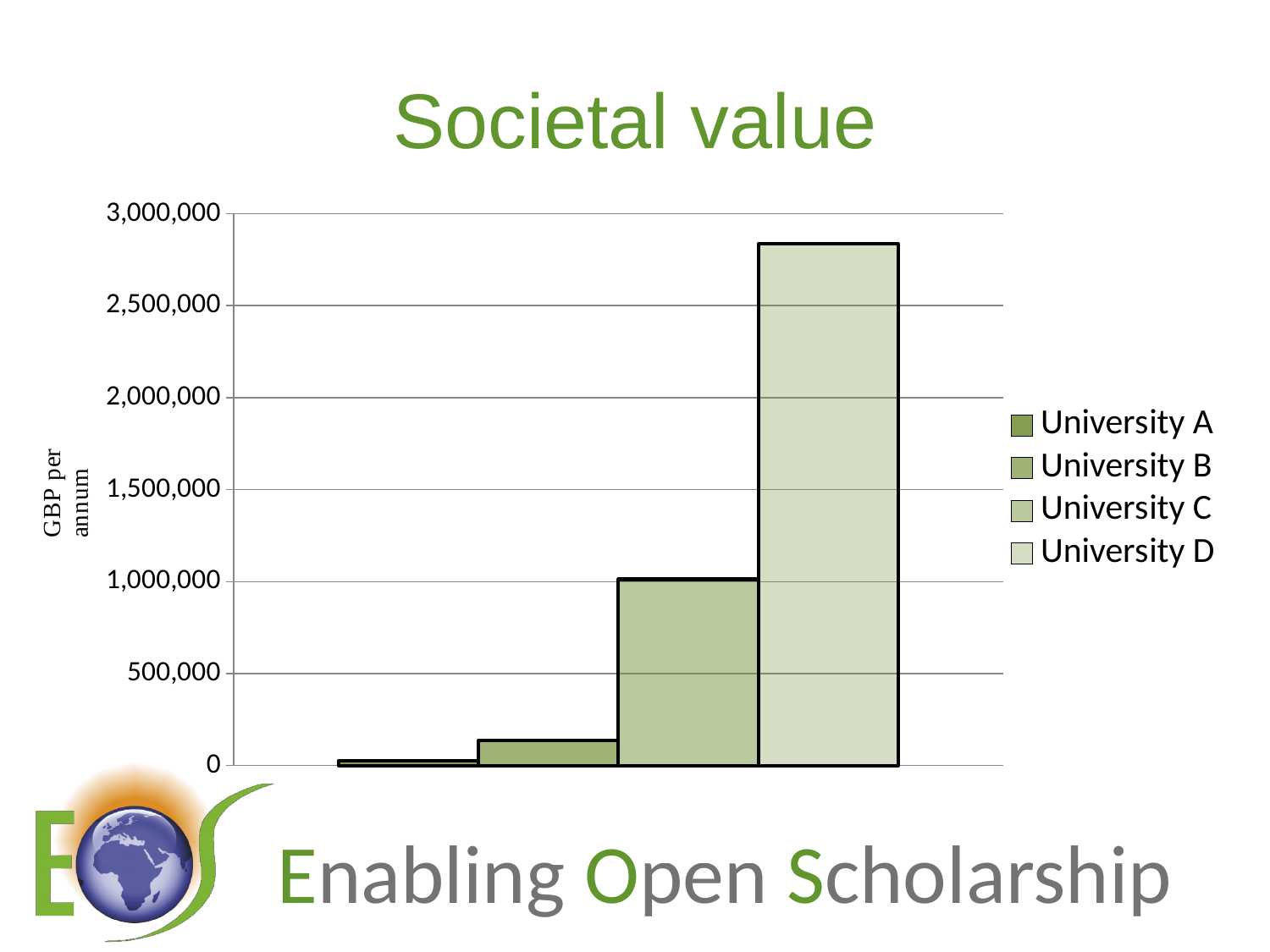
What kind of chart is shown on the slide? bar chart What is the label on the vertical axis of the chart? GBP per annum Which is larger, the value for University D or the value for University C? University D Which university has the lowest societal value? University A Is the value for University D greater or less than 2,500,000? greater How many bars are plotted in the chart? 4 How many series does the legend list? 4 Is the value for University B greater or less than 500,000? less Do the bar values rise or fall from University A to University D? rise Which university has the highest societal value? University D Which is larger, the value for University C or the value for University B? University C Is the value for University C greater or less than 1,500,000? less